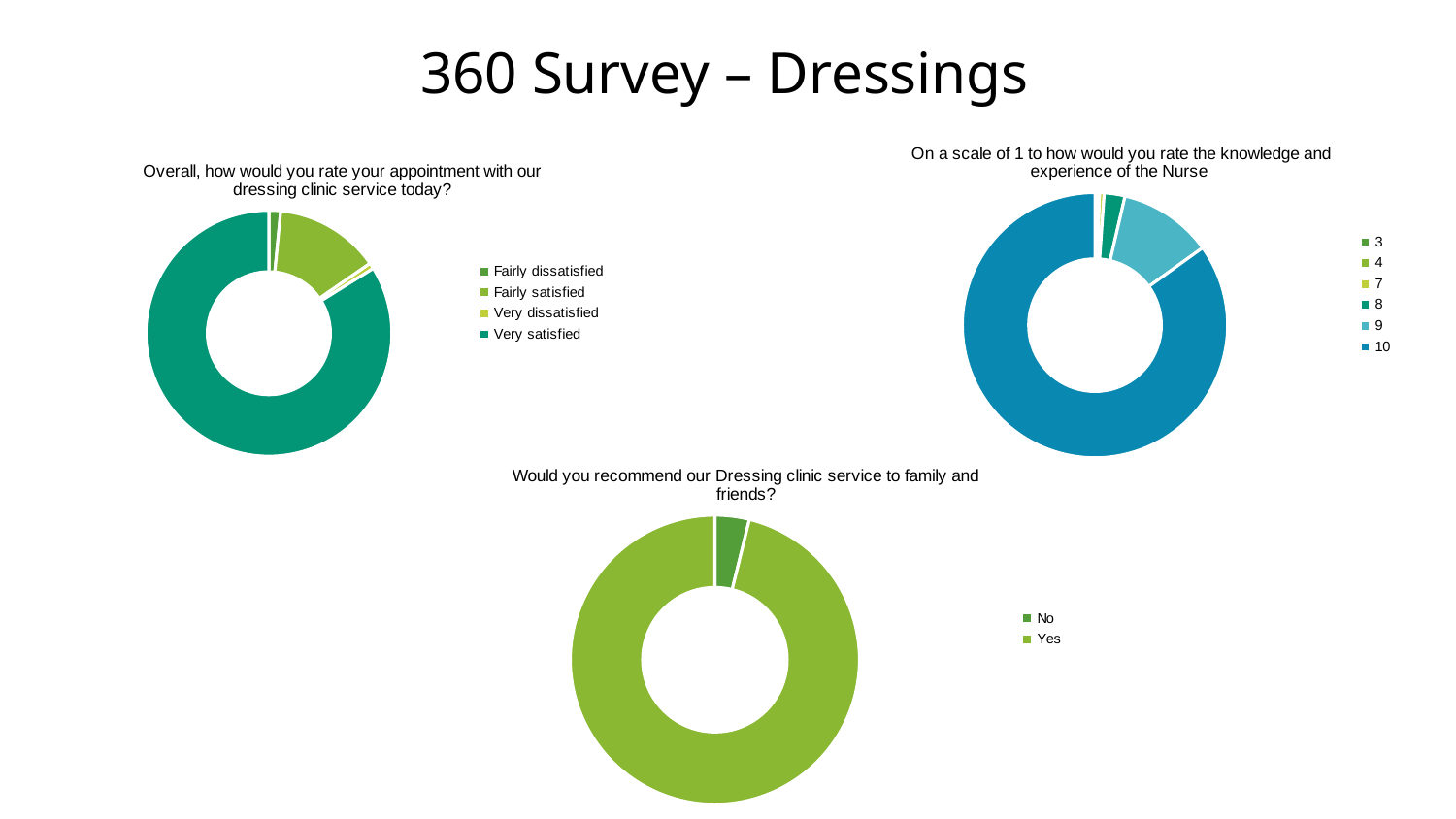
What is the title of the slide? 360 Survey – Dressings How many categories does the legend list for the chart 'Overall, how would you rate your appointment with our dressing clinic service today?'? 4 In the chart 'Overall, how would you rate your appointment with our dressing clinic service today?', which category has the largest share? Very satisfied How many charts are shown on the slide? 3 In the chart 'Would you recommend our Dressing clinic service to family and friends?', which answer has the smallest share? No In the chart 'On a scale of 1 to how would you rate the knowledge and experience of the Nurse', which is larger: the share for 10 or the share for 9? 10 In the chart 'Would you recommend our Dressing clinic service to family and friends?', which answer has the largest share? Yes In the chart 'Overall, how would you rate your appointment with our dressing clinic service today?', which is larger: Fairly satisfied or Fairly dissatisfied? Fairly satisfied How many categories does the legend list for the chart 'Would you recommend our Dressing clinic service to family and friends?'? 2 What kind of chart is used for 'Overall, how would you rate your appointment with our dressing clinic service today?'? Doughnut chart How many categories does the legend list for the chart 'On a scale of 1 to how would you rate the knowledge and experience of the Nurse'? 6 In the chart 'On a scale of 1 to how would you rate the knowledge and experience of the Nurse', which rating has the largest share? 10